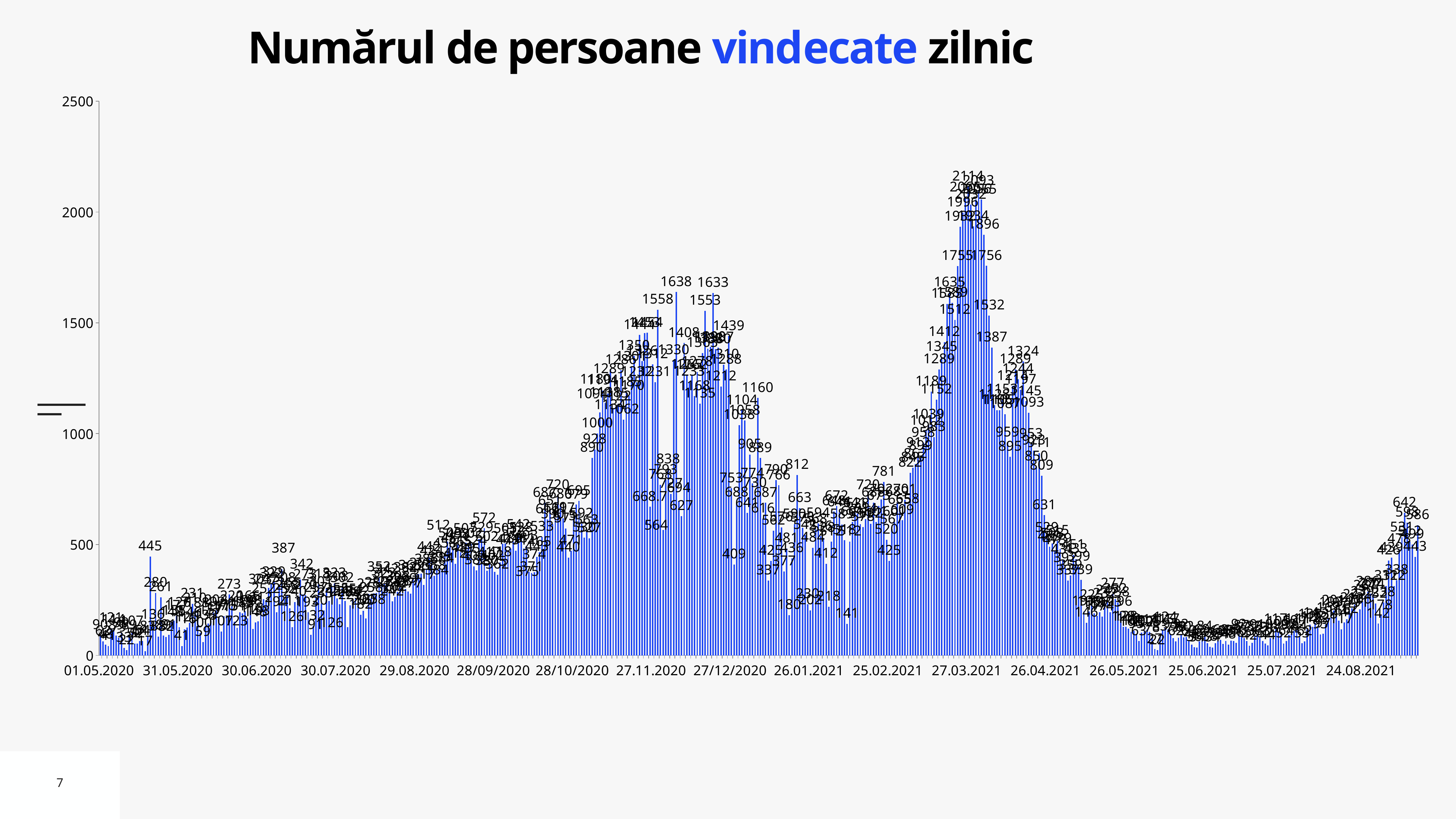
What is the maximum value shown on the y axis? 2500 What is the highest value labeled in May 2020 (between 01.05.2020 and 31.05.2020)? 445 What is the highest value labeled on the chart? 2114 What is the highest value labeled in the wave around 27.11.2020? 1638 Is the highest value on the chart greater or less than 2000? greater What is the title of the chart? Numărul de persoane vindecate zilnic Do the values rise or fall between 27.03.2021 and 26.05.2021? fall Which peak is higher: the one around 27.11.2020 or the one around 27.03.2021? 27.03.2021 Around which x-axis date does the chart reach its highest peak? 27.03.2021 What is the difference between the peak value around 27.03.2021 (2114) and the peak value around 27.11.2020 (1638)? 476 Are the values at the start of the chart (01.05.2020) greater or less than 500? less What kind of chart is shown on the slide? bar chart